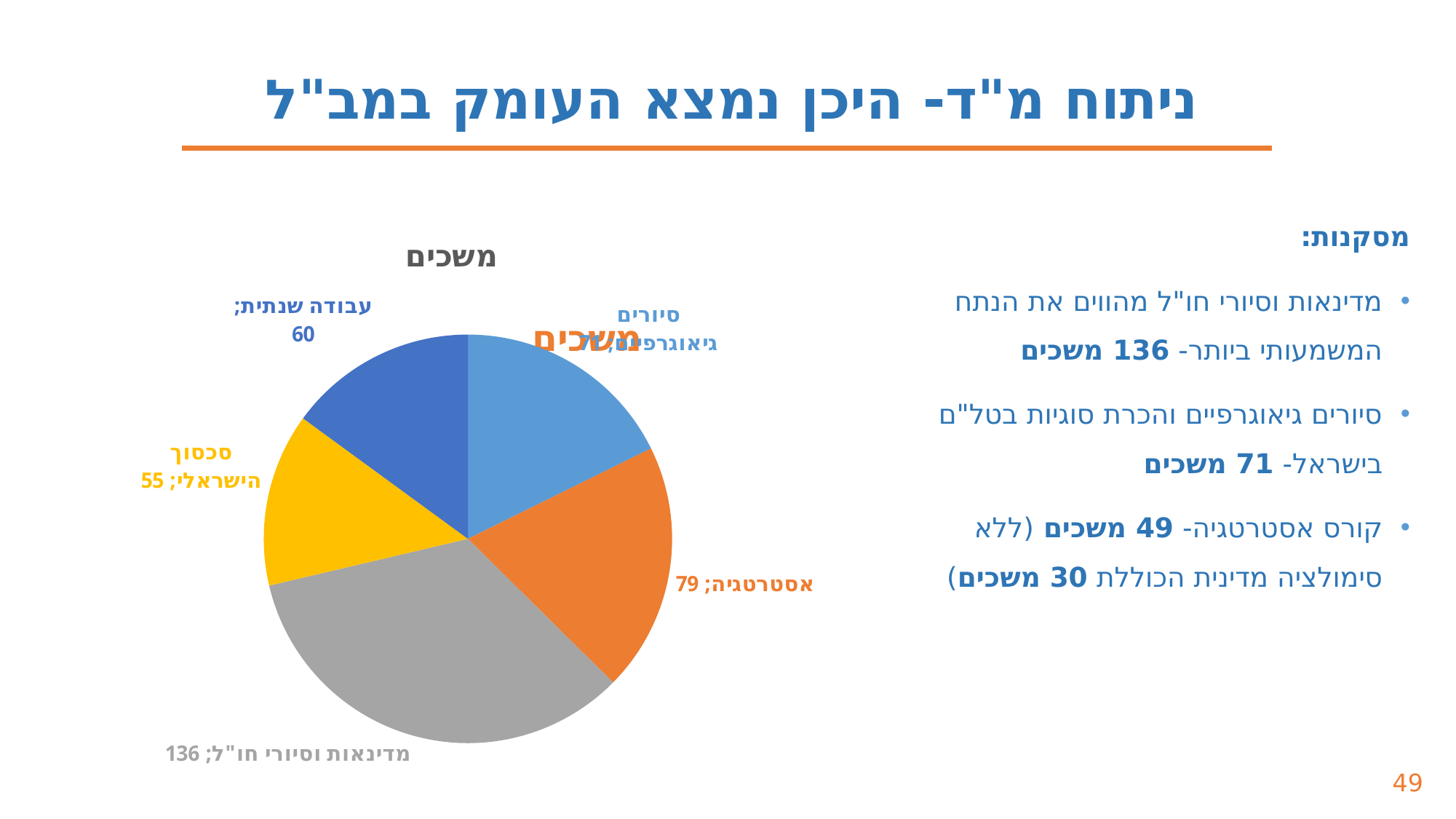
What is the title of the pie chart? משכים What is the value for אסטרטגיה in the pie chart? 79 What kind of chart is shown on the slide? pie chart What is the difference between the values for מדינאות וסיורי חו"ל and אסטרטגיה? 57 What is the value for מדינאות וסיורי חו"ל in the pie chart? 136 Which category has the smallest slice in the pie chart? סכסוך הישראלי What is the value for סכסוך הישראלי in the pie chart? 55 What is the difference between the values for עבודה שנתית and סכסוך הישראלי? 5 Which is larger, the value for אסטרטגיה or the value for עבודה שנתית? אסטרטגיה Which category has the largest slice in the pie chart? מדינאות וסיורי חו"ל How many slices does the pie chart have? 5 What is the value for עבודה שנתית in the pie chart? 60